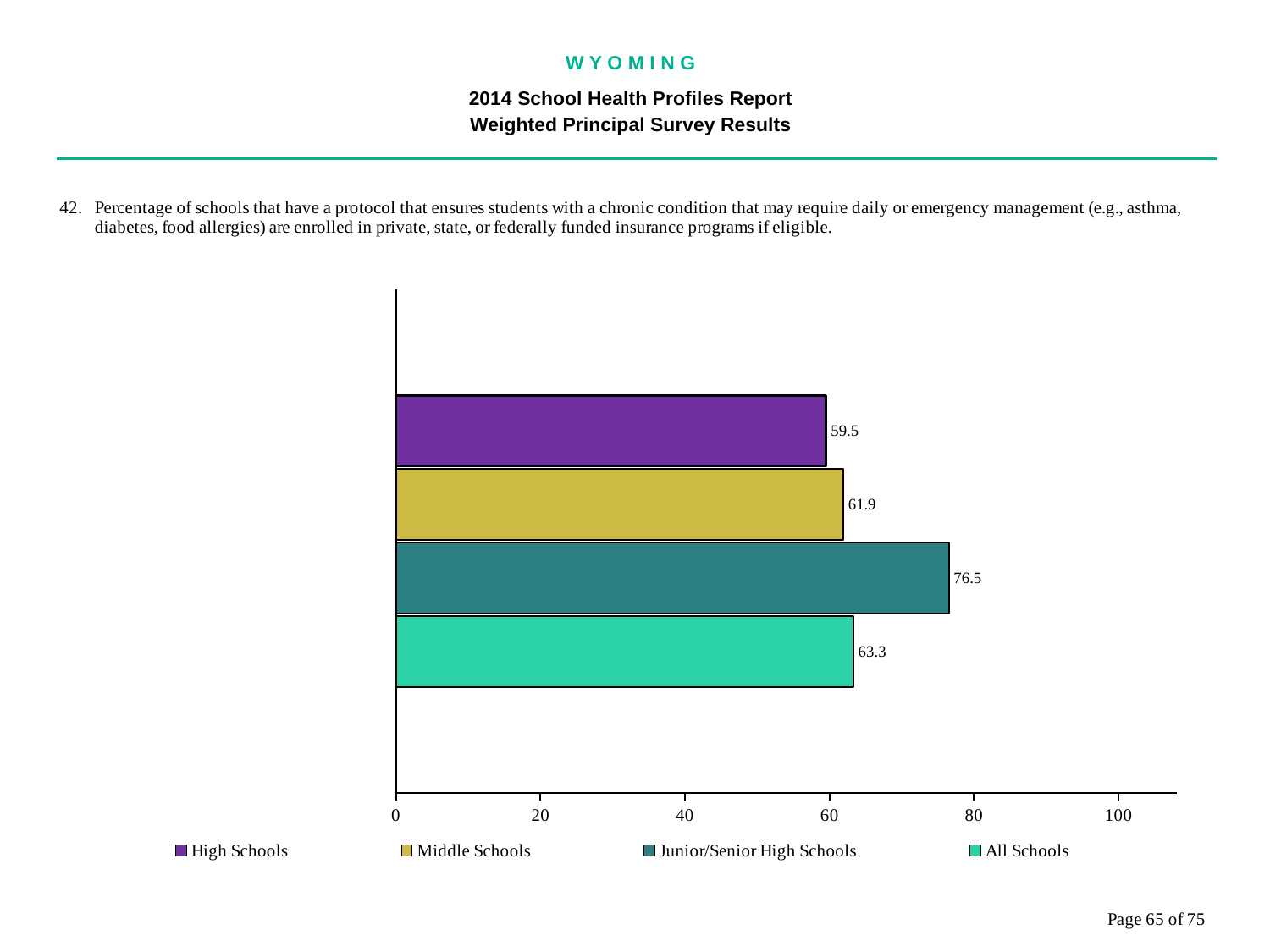
What is the value for High Schools? 59.5 How many series does the legend list? 4 What is the value for All Schools? 63.3 What is the value for Middle Schools? 61.9 What kind of chart is shown on the slide? bar chart What is the difference between the values for Junior/Senior High Schools and High Schools? 17.0 Is the value for High Schools greater or less than 60? less Which school category has the lowest value? High Schools What is the difference between the values for All Schools and Middle Schools? 1.4 Which is larger, the value for Junior/Senior High Schools or the value for All Schools? Junior/Senior High Schools What is the value for Junior/Senior High Schools? 76.5 Which school category has the highest value? Junior/Senior High Schools